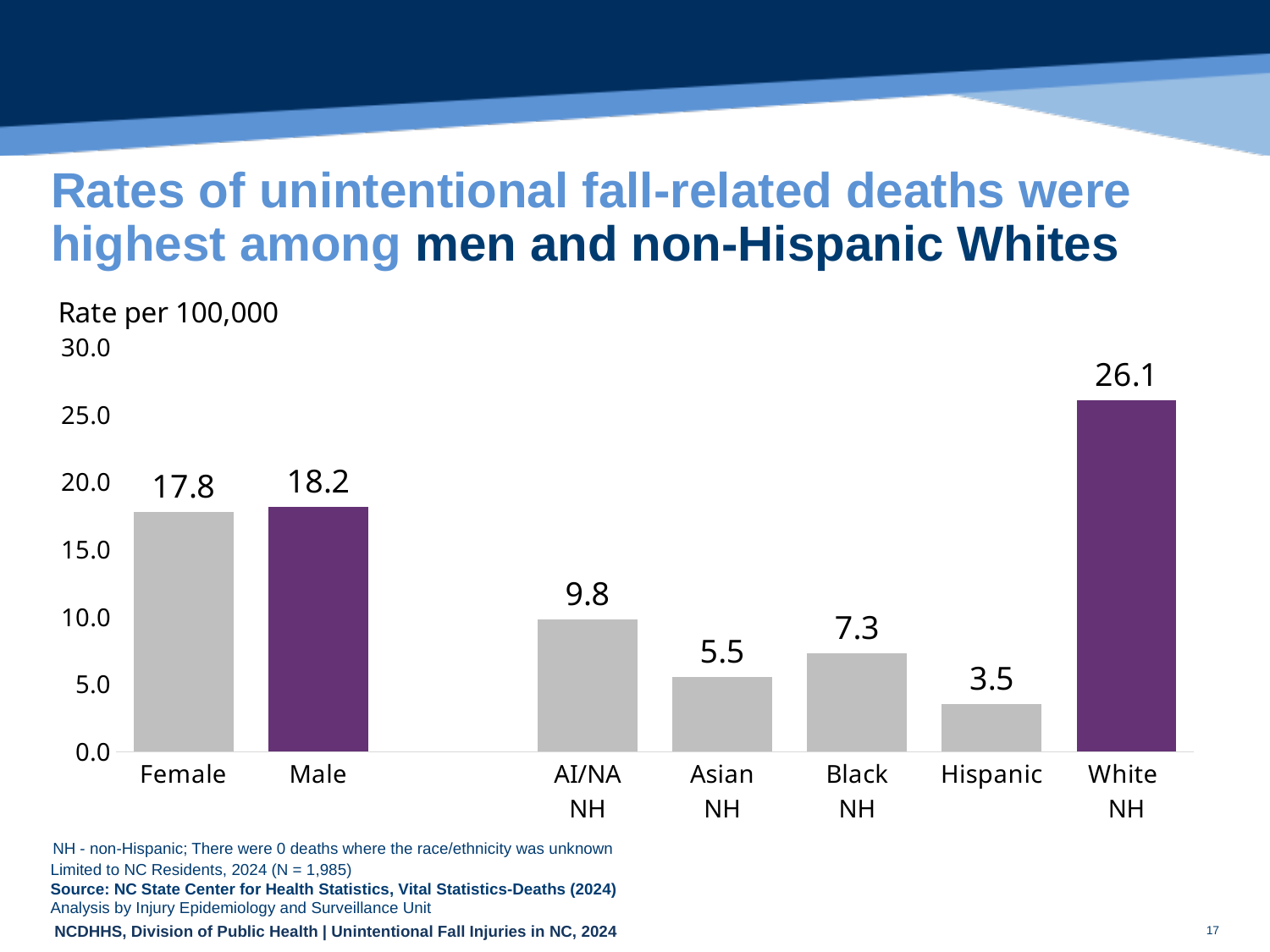
How many categories are shown in the chart? 7 Is the rate for Black NH greater or less than 10.0? less What is the difference between the rates for Male and Female? 0.4 Which category has the lowest rate? Hispanic Which has a higher rate, AI/NA NH or Asian NH? AI/NA NH What is the rate per 100,000 for Hispanic? 3.5 What is the label of the vertical axis? Rate per 100,000 What is the rate per 100,000 for Female? 17.8 What kind of chart is shown on the slide? bar chart What is the difference between the rates for White NH and Black NH? 18.8 Which category has the highest rate? White NH What is the rate per 100,000 for White NH? 26.1